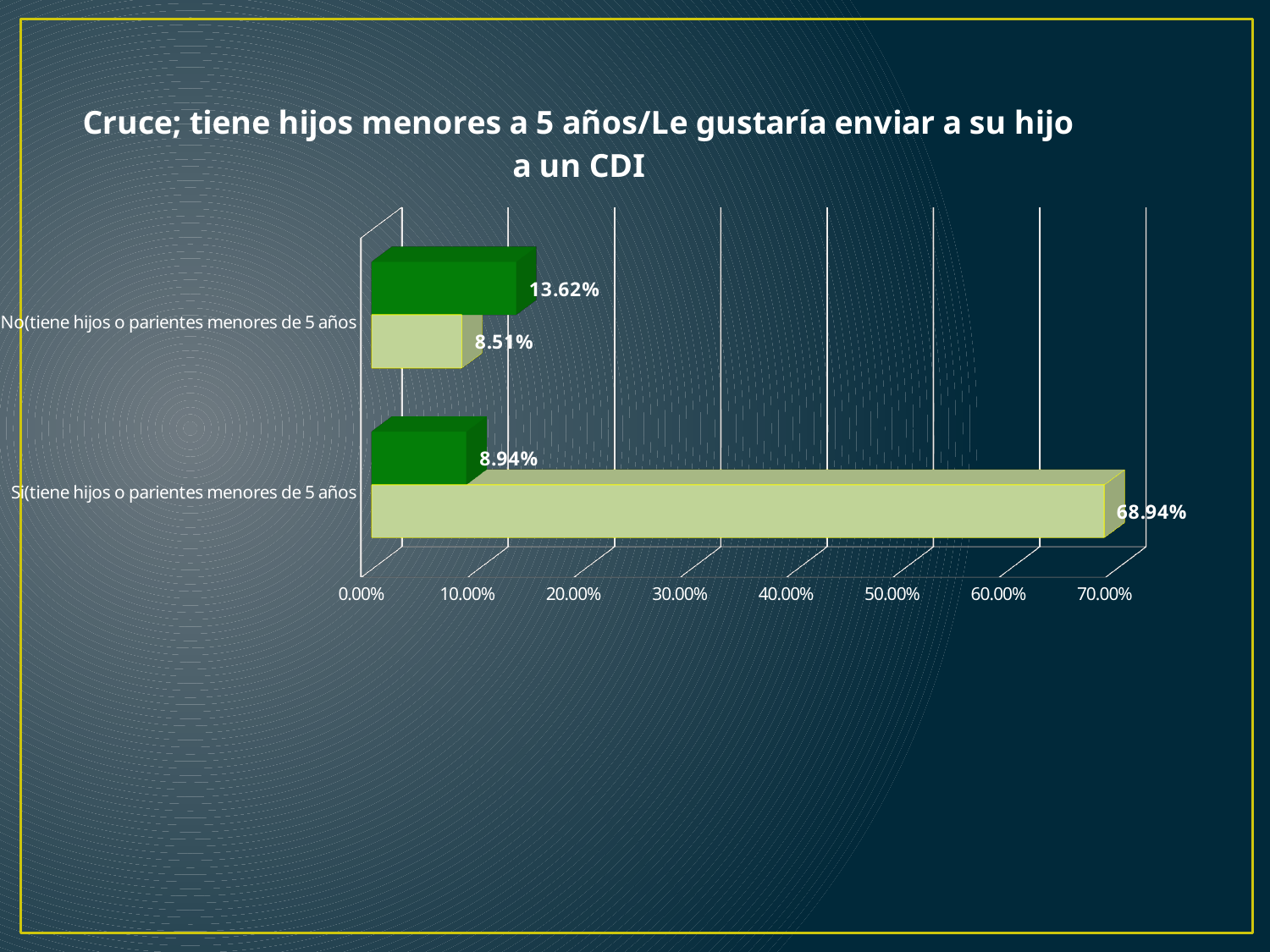
Which bar has the highest value in the chart? the light green bar for Si(tiene hijos o parientes menores de 5 años How many categories are shown on the vertical axis of the chart? 2 What is the difference between the light green bar values for 'Si' and 'No' (tiene hijos o parientes menores de 5 años)? 60.43% What is the title of the chart? Cruce; tiene hijos menores a 5 años/Le gustaría enviar a su hijo a un CDI What kind of chart is shown on the slide? bar chart What is the value of the dark green bar for 'Si(tiene hijos o parientes menores de 5 años'? 8.94% What is the value of the light green bar for 'No(tiene hijos o parientes menores de 5 años'? 8.51% What is the value of the dark green bar for 'No(tiene hijos o parientes menores de 5 años'? 13.62% Is the value of the light green bar for 'Si(tiene hijos o parientes menores de 5 años' greater or less than 60.00%? greater What is the value of the light green bar for 'Si(tiene hijos o parientes menores de 5 años'? 68.94% Which is larger for 'No(tiene hijos o parientes menores de 5 años': the dark green bar or the light green bar? the dark green bar Which bar has the lowest value in the chart? the light green bar for No(tiene hijos o parientes menores de 5 años